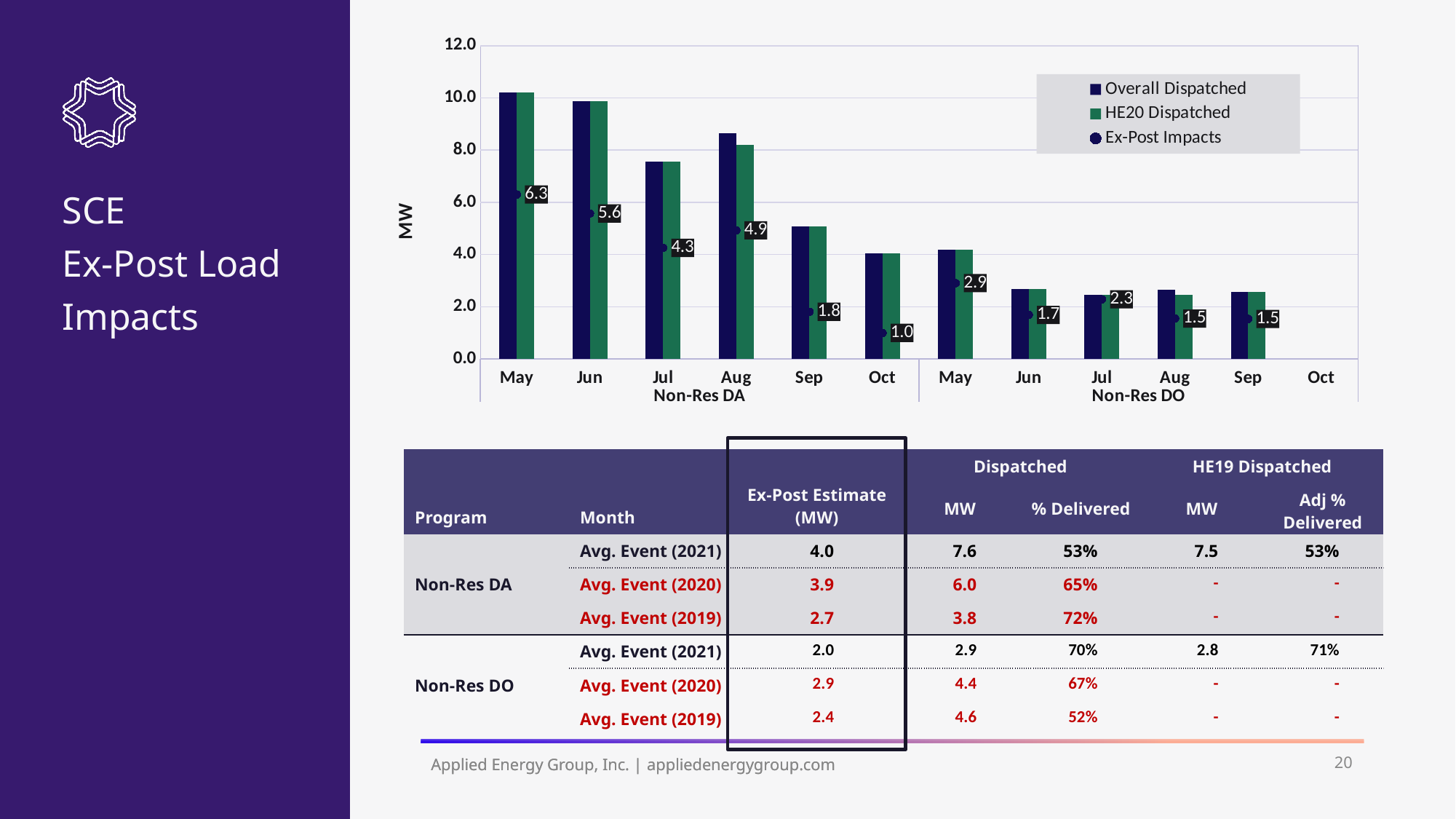
Is the Overall Dispatched value for May in the Non-Res DA group greater or less than 10.0? greater What is the label on the vertical axis of the chart? MW What is the Ex-Post Impacts value for Jul in the Non-Res DO group? 2.3 Which month and program has the lowest Ex-Post Impacts value? Oct, Non-Res DA What is the Ex-Post Impacts value for May in the Non-Res DA group? 6.3 Is the Overall Dispatched value for Aug in the Non-Res DA group greater or less than 8.0? greater What kind of chart is shown on the slide? bar chart In the Non-Res DA group, which month has the larger Ex-Post Impacts value, Jul or Aug? Aug What is the difference between the Ex-Post Impacts values for May and Jun in the Non-Res DA group? 0.7 Which month and program has the highest Ex-Post Impacts value? May, Non-Res DA How many series does the chart legend list? 3 Do the Ex-Post Impacts values rise or fall from May to Oct in the Non-Res DA group? fall